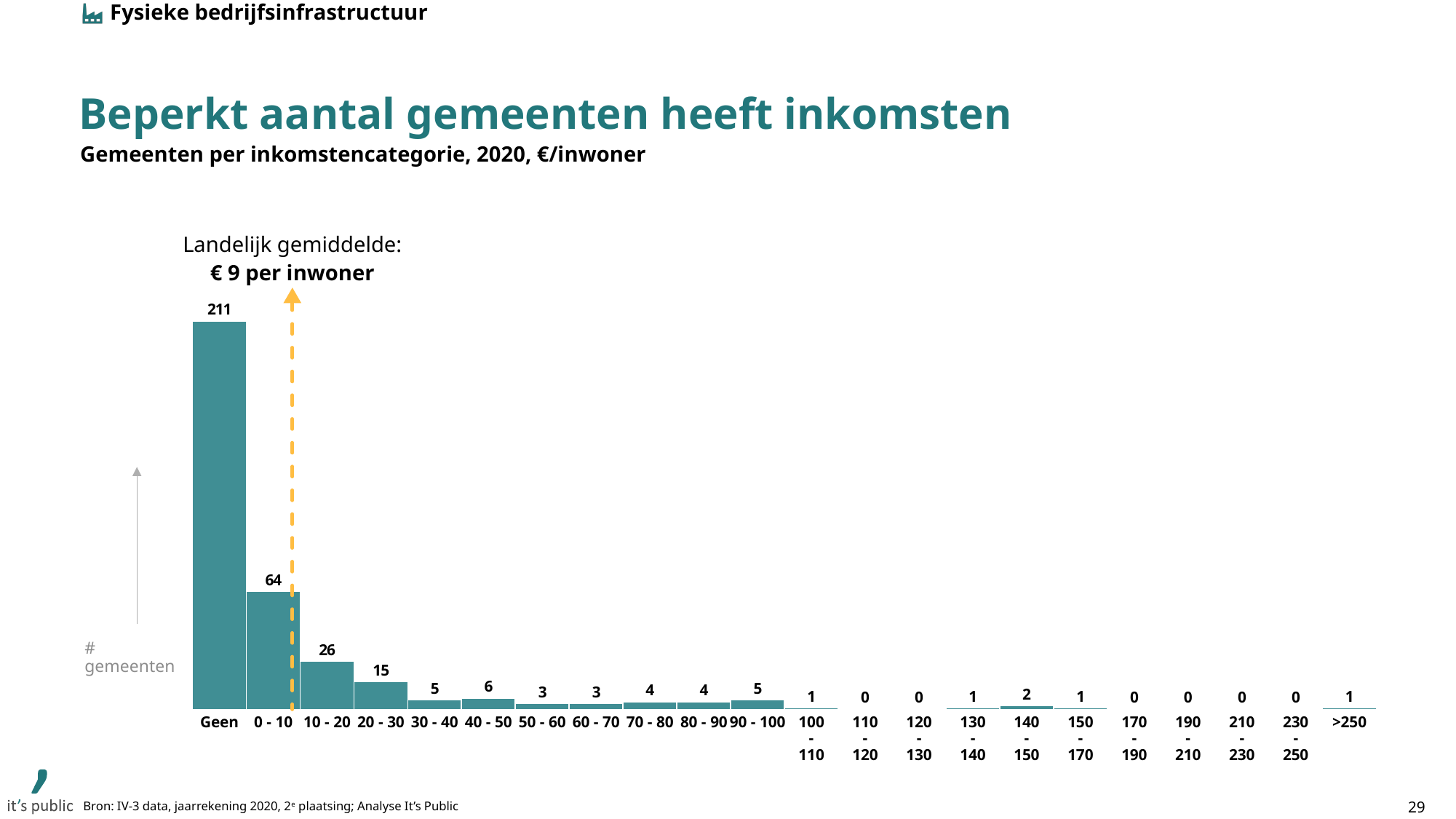
What is the difference between the 'Geen' and '0 - 10' categories? 147 What is the difference between the '10 - 20' and '20 - 30' categories? 11 How many income categories are shown on the x axis? 22 How many municipalities fall in the '10 - 20' income category? 26 What kind of chart is shown on the slide? Bar chart What is the value shown for the '140 - 150' category? 2 What national average (Landelijk gemiddelde) is indicated by the dashed line? € 9 per inwoner How many municipalities are in the '>250' category? 1 Which is larger, the value for '40 - 50' or the value for '30 - 40'? 40 - 50 What is the value for the '0 - 10' category? 64 How many municipalities are in the 'Geen' category? 211 Which category has the highest number of municipalities? Geen